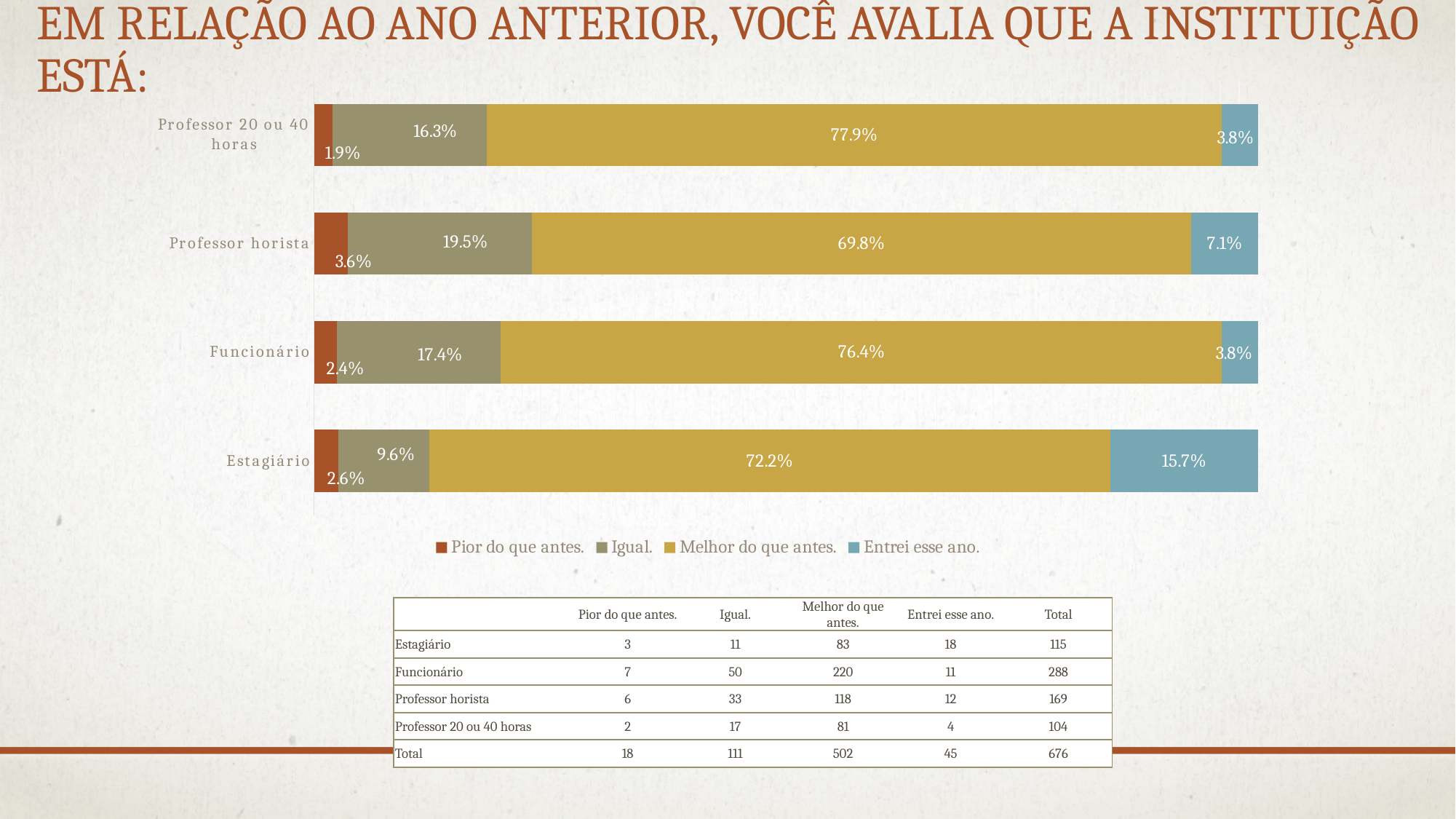
What is the difference between the "Entrei esse ano." values for Estagiário and Professor horista? 8.6% Which category has the highest value for "Melhor do que antes."? Professor 20 ou 40 horas What is the value for "Igual." for Professor horista? 19.5% Which category has the highest value for "Entrei esse ano."? Estagiário How many series does the legend list? 4 What is the value for "Pior do que antes." for Funcionário? 2.4% How many categories are shown on the chart? 4 Which is larger: the "Igual." value for Funcionário or for Professor 20 ou 40 horas? Funcionário What is the value for "Entrei esse ano." for Estagiário? 15.7% What kind of chart is shown on the slide? Stacked bar chart What is the value for "Melhor do que antes." for Professor 20 ou 40 horas? 77.9% Which category has the lowest value for "Igual."? Estagiário